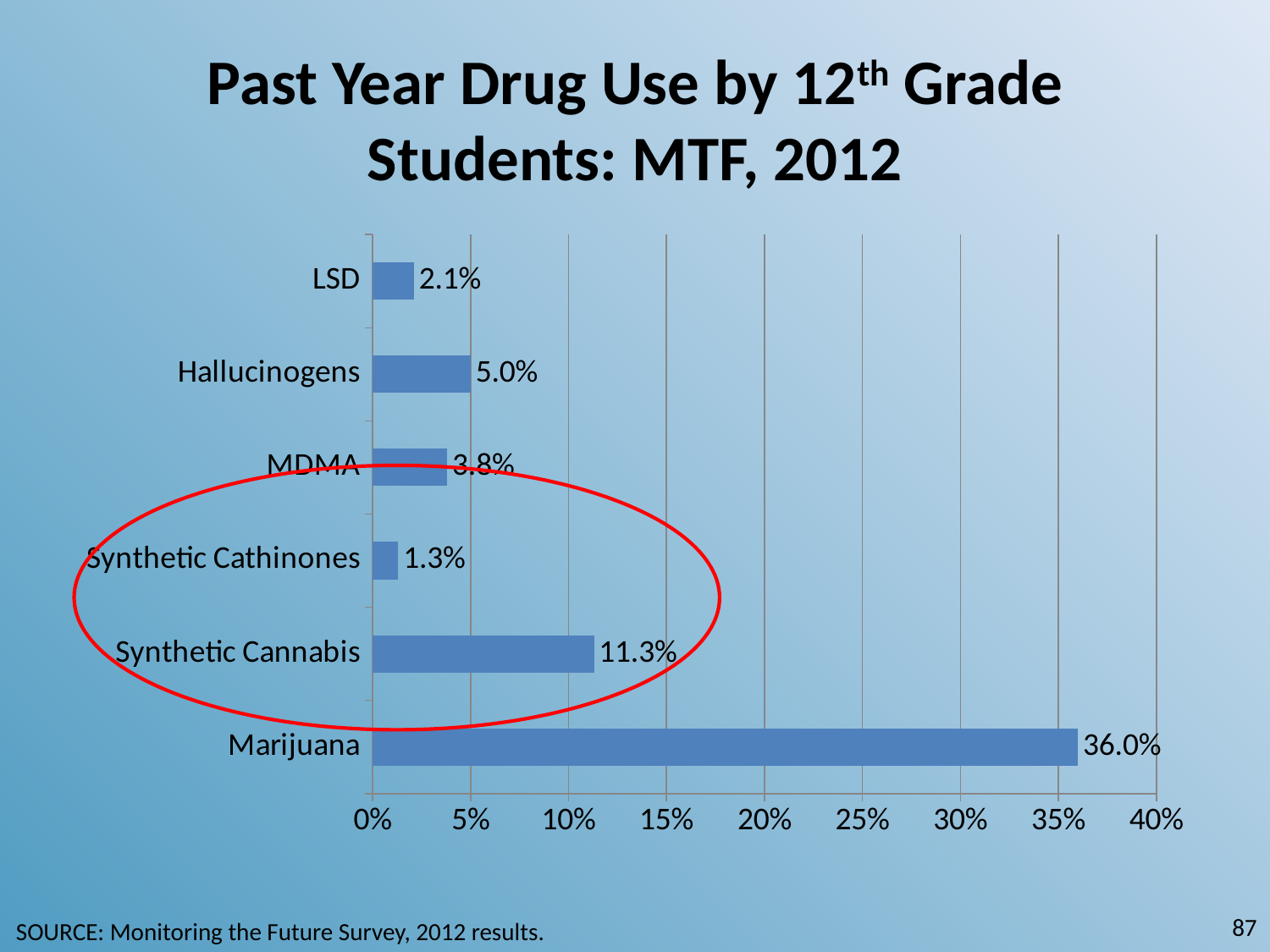
What is the value shown for Synthetic Cathinones? 1.3% Which is larger, the value for Hallucinogens or the value for MDMA? Hallucinogens Which drug has the lowest past year use value? Synthetic Cathinones How many drug categories are shown in the chart? 6 Which drug has the highest past year use value? Marijuana What is the past year use value for Marijuana? 36.0% Is the value for Synthetic Cannabis greater or less than 10%? greater What is the value shown for Hallucinogens? 5.0% What is the value shown for Synthetic Cannabis? 11.3% What kind of chart is shown on the slide? Bar chart Which two categories are circled in red on the chart? Synthetic Cathinones and Synthetic Cannabis What is the difference between the values for Marijuana and Synthetic Cannabis? 24.7%